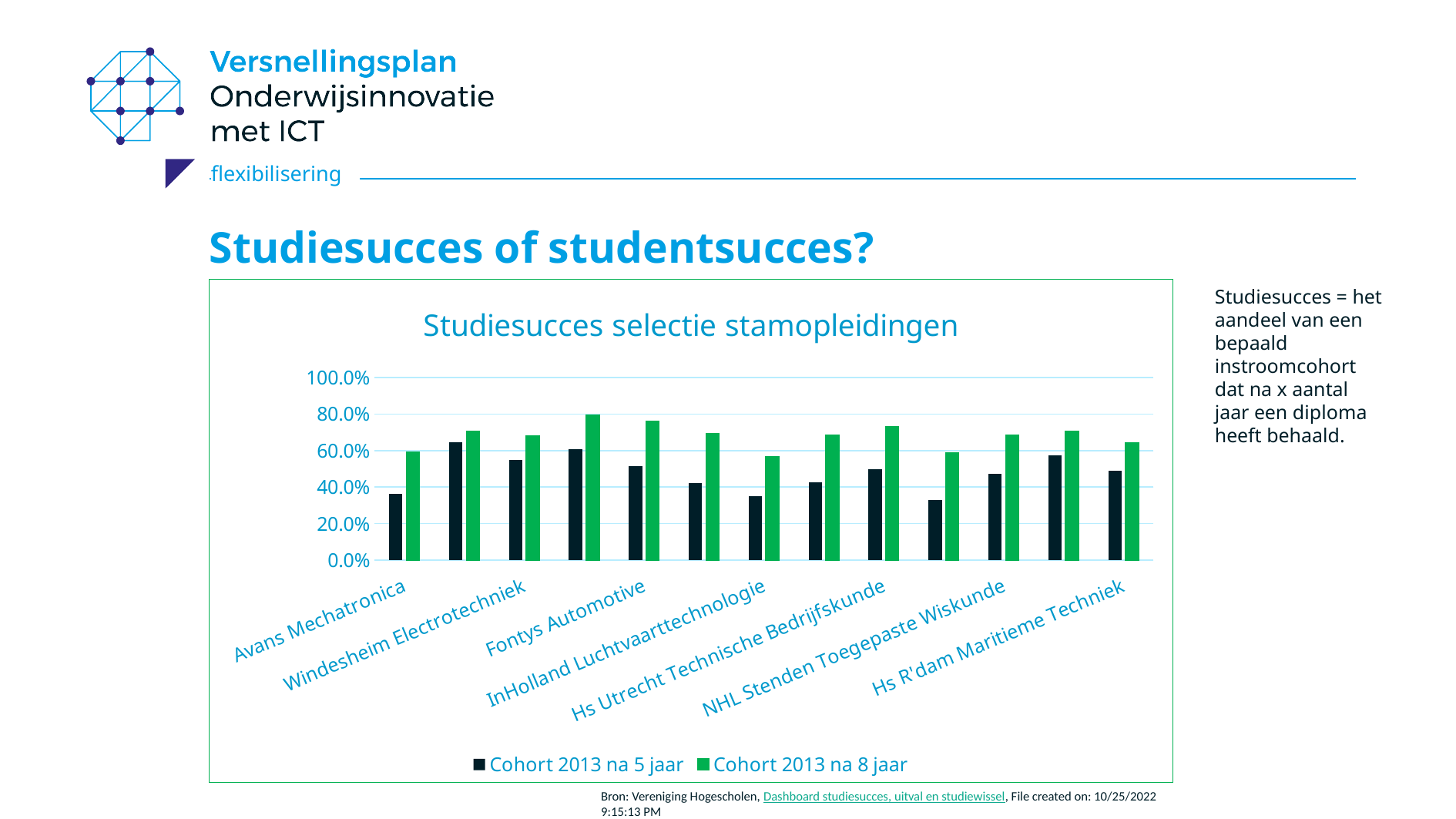
Is the value for NHL Stenden Toegepaste Wiskunde for Cohort 2013 na 5 jaar greater or less than 40.0%? greater How many series does the legend list? 2 Which labeled opleiding has the highest value for Cohort 2013 na 8 jaar? Fontys Automotive For Cohort 2013 na 5 jaar, which is larger: Windesheim Electrotechniek or Avans Mechatronica? Windesheim Electrotechniek Is the value for Windesheim Electrotechniek for Cohort 2013 na 5 jaar greater or less than 60.0%? less Is the value for Avans Mechatronica for Cohort 2013 na 5 jaar greater or less than 40.0%? less What kind of chart is shown on the slide? bar chart For Fontys Automotive, which series has the larger value: Cohort 2013 na 5 jaar or Cohort 2013 na 8 jaar? Cohort 2013 na 8 jaar What is the title of the chart? Studiesucces selectie stamopleidingen Which series is shown in green in the chart? Cohort 2013 na 8 jaar